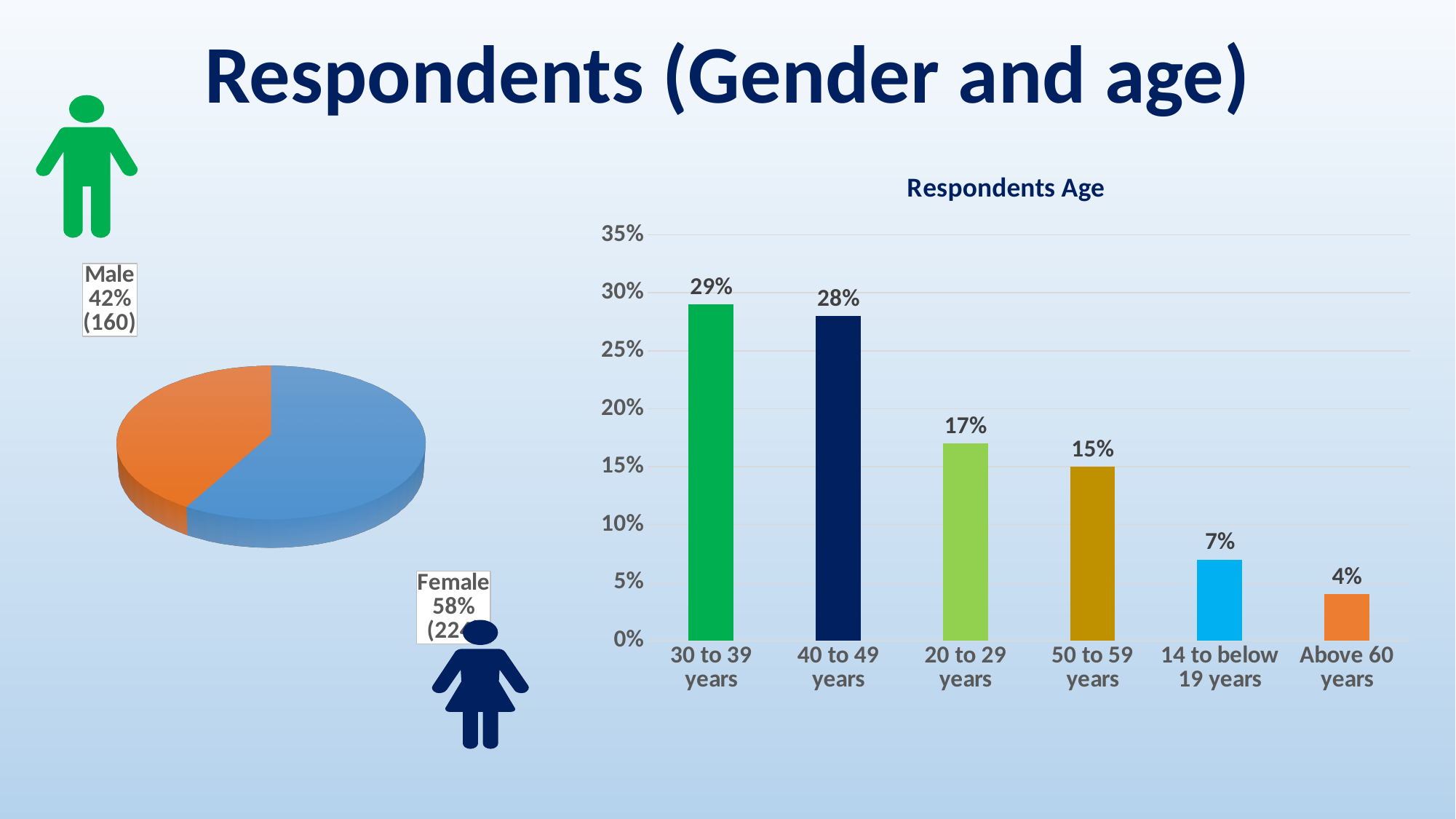
In the Respondents Age bar chart, what is the value for 30 to 39 years? 29% In the Respondents Age bar chart, which is larger: the value for 40 to 49 years or the value for 50 to 59 years? 40 to 49 years In the pie chart on the left, what share of respondents is Female? 58% In the Respondents Age bar chart, what is the value for Above 60 years? 4% In the Respondents Age bar chart, what is the difference between the values for 20 to 29 years and 14 to below 19 years? 10% How many age groups are shown in the Respondents Age bar chart? 6 In the pie chart on the left, how many respondents are Male? 160 In the Respondents Age bar chart, which age group has the lowest value? Above 60 years In the Respondents Age bar chart, which age group has the highest value? 30 to 39 years What kind of chart is the Respondents Age chart? Bar chart In the pie chart on the left, what share of respondents is Male? 42% In the Respondents Age bar chart, what is the value for 50 to 59 years? 15%